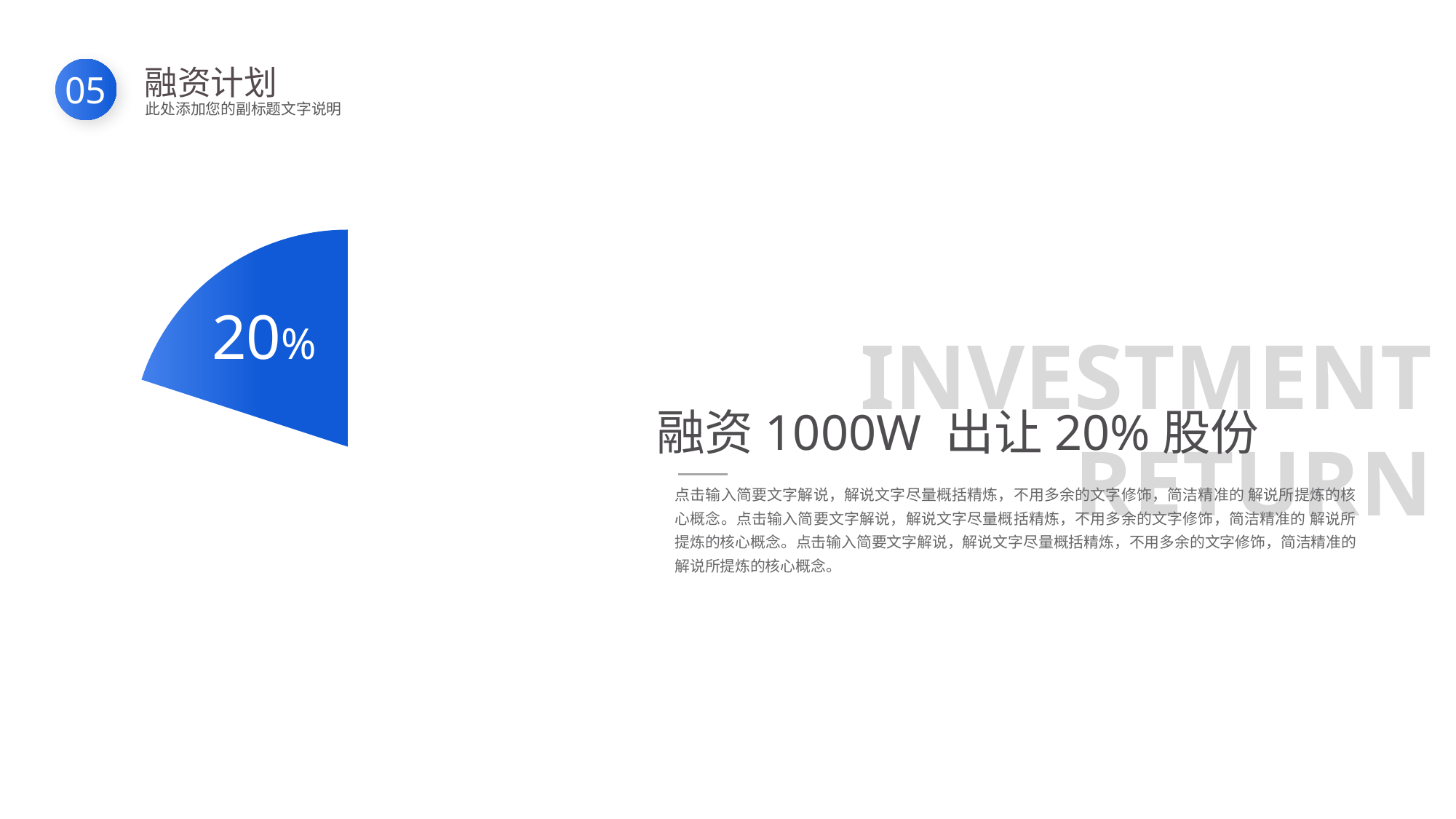
What colour is the pie slice labelled 20%? blue What kind of chart is shown on the left of the slide? pie chart According to the headline next to the chart, what percentage of shares is being offered? 20% How many slices are visibly drawn in the pie chart? 1 Is the share shown by the blue slice greater or less than 50%? less What share of the whole does the blue slice represent? 20% What percentage is printed on the blue pie slice? 20%